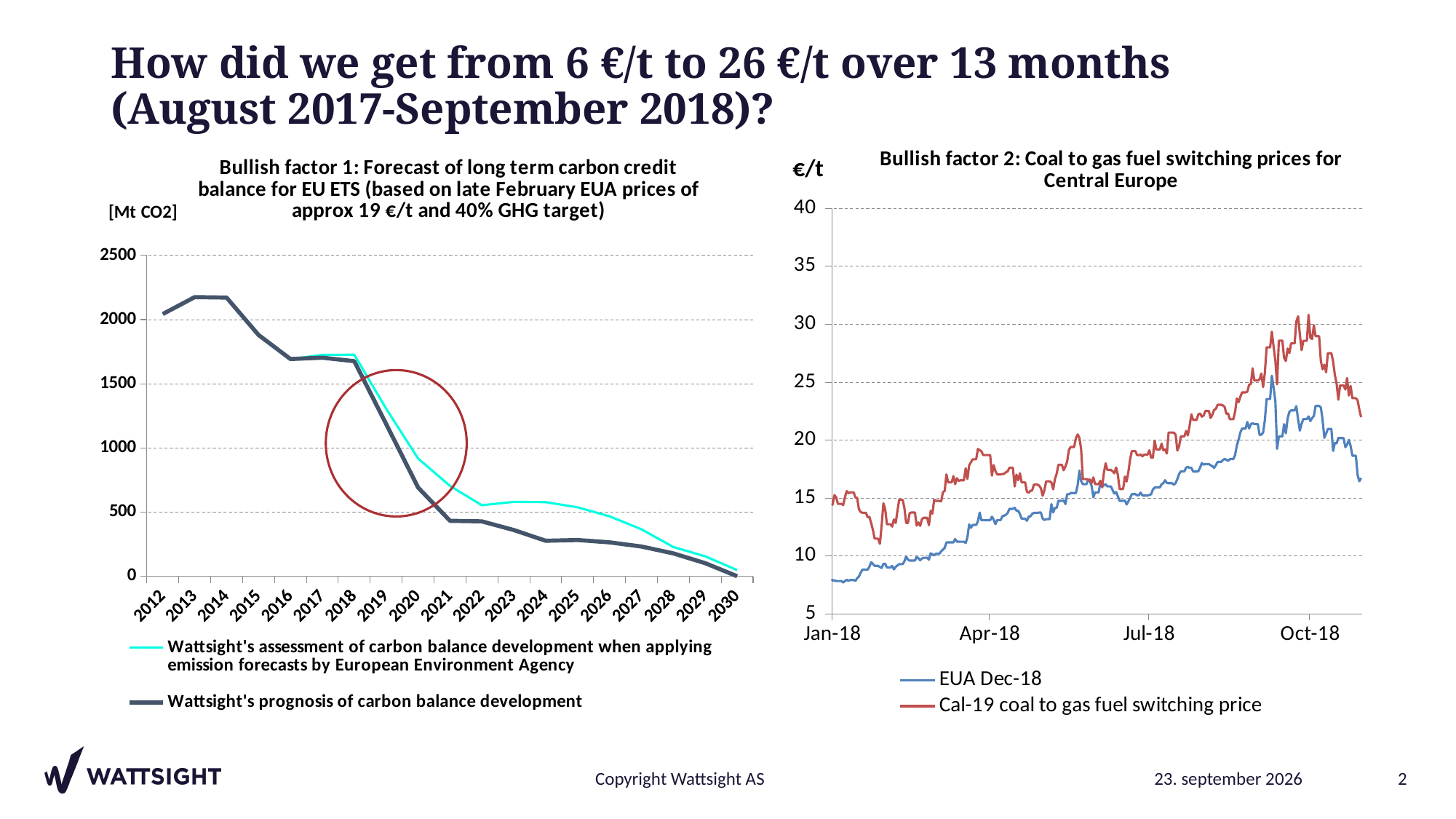
What kind of chart is the 'Bullish factor 1' chart on the left? line chart In the left chart ('Bullish factor 1'), is the value of Wattsight's prognosis of carbon balance development for 2021 greater or less than 500? less In the left chart ('Bullish factor 1'), which series has the higher value in 2022: the assessment applying European Environment Agency forecasts or Wattsight's prognosis? Wattsight's assessment of carbon balance development when applying emission forecasts by European Environment Agency In the left chart ('Bullish factor 1'), is the value of Wattsight's prognosis of carbon balance development for 2013 greater or less than 2000? greater What unit is shown on the y axis of the right chart ('Bullish factor 2')? €/t In the right chart ('Bullish factor 2'), does the EUA Dec-18 price generally rise or fall from Jan-18 to Oct-18? rise In the right chart ('Bullish factor 2'), is the EUA Dec-18 value at Jan-18 greater or less than 10? less How many series does the legend of the left chart ('Bullish factor 1') list? 2 In the left chart ('Bullish factor 1'), do the values of Wattsight's prognosis generally rise or fall from 2014 to 2030? fall In the left chart ('Bullish factor 1'), which year has the lowest value for Wattsight's prognosis of carbon balance development? 2030 How many series does the legend of the right chart ('Bullish factor 2') list? 2 How many years are shown on the x axis of the left chart ('Bullish factor 1')? 19